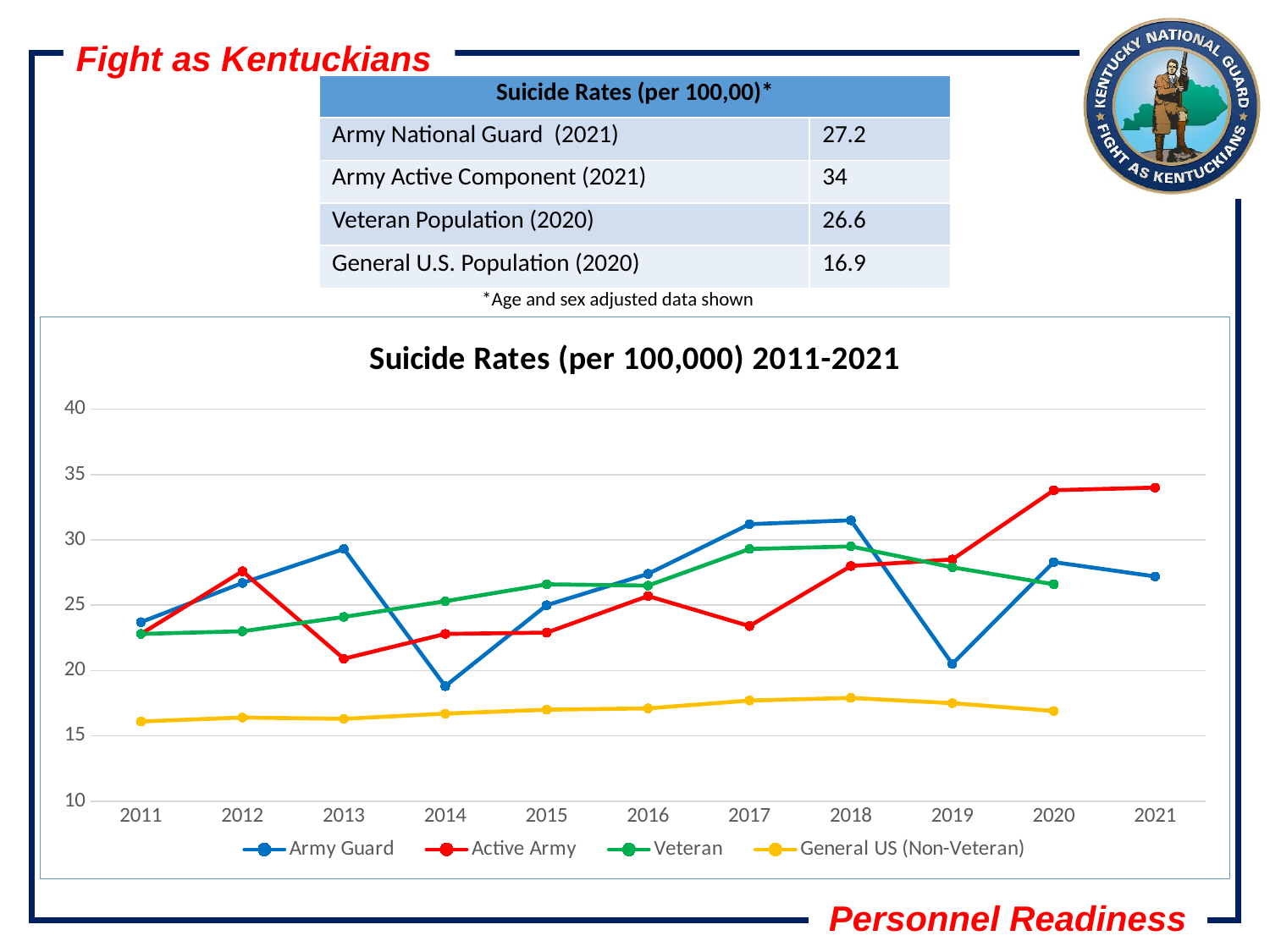
What is the title of the chart? Suicide Rates (per 100,000) 2011-2021 In which year is the Army Guard series at its lowest? 2014 In 2019, which is larger: the Army Guard value or the Active Army value? Active Army Is the Active Army value for 2021 greater or less than 30? greater Which series has the highest value in 2021? Active Army Does the Active Army series rise or fall from 2018 to 2021? rise Is the Army Guard value for 2014 greater or less than 20? less What kind of chart is shown on the slide? line chart Is the Active Army value for 2013 greater or less than 25? less How many series does the chart legend list? 4 What colour is the Active Army line in the chart? red How many years are shown on the x axis of the chart? 11